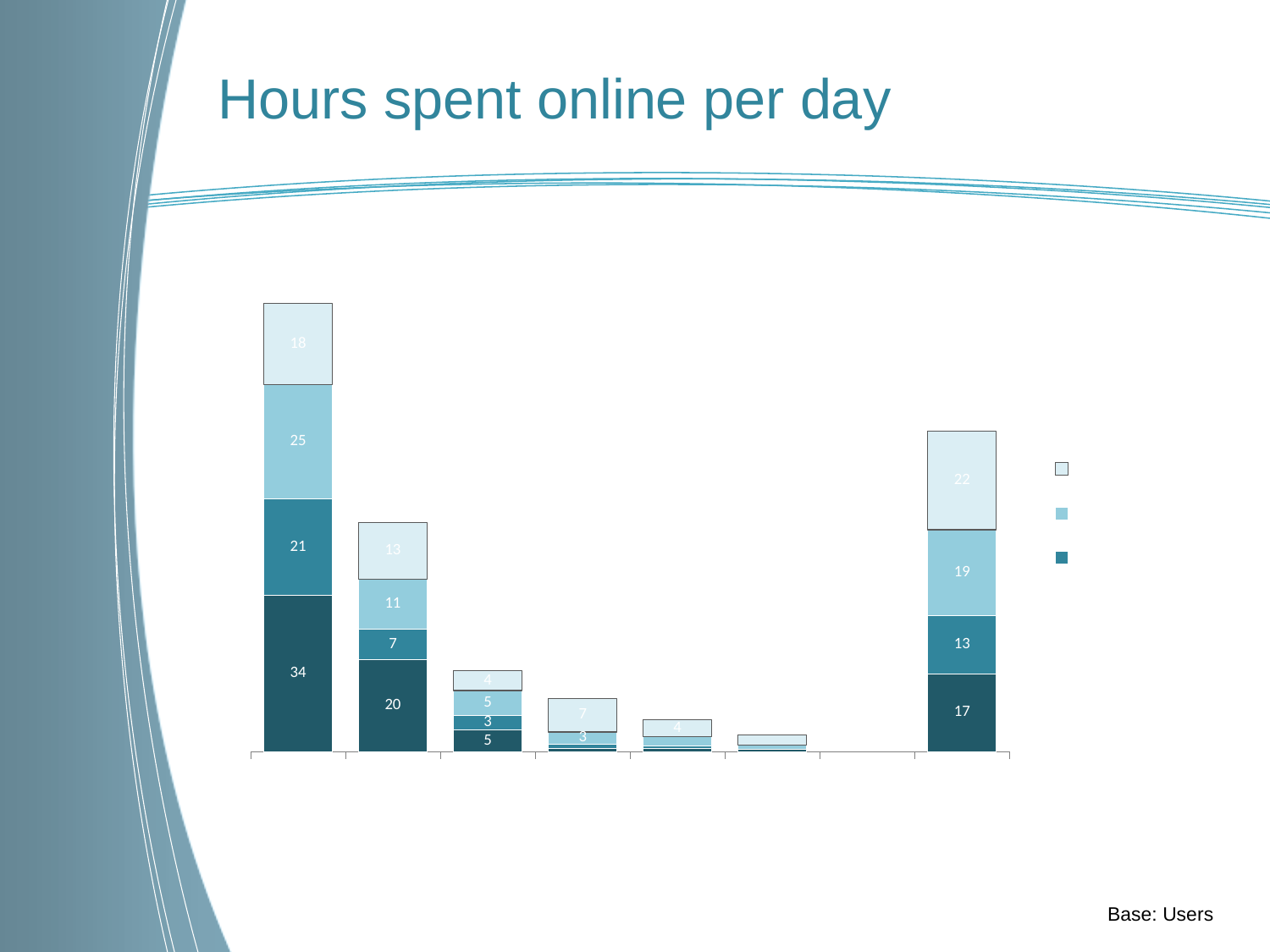
What kind of chart is shown on the slide? Stacked bar chart What is the value of the darkest (bottom) segment of the second bar from the left? 20 How many segments are stacked in the leftmost bar? 4 What is the total of the leftmost stacked bar (34, 21, 25 and 18)? 98 What is the difference between the darkest segment of the leftmost bar (34) and the darkest segment of the rightmost bar (17)? 17 What is the title of the chart on the slide? Hours spent online per day Which is larger: the darkest segment of the leftmost bar or the darkest segment of the rightmost bar? The leftmost bar's (34) What is the value of the lightest (top) segment of the rightmost bar? 22 What is the value of the darkest (bottom) segment of the leftmost bar? 34 What is the total of the rightmost stacked bar (17, 13, 19 and 22)? 71 What base is stated for the chart at the bottom of the slide? Base: Users Which bar is the tallest overall? The leftmost bar